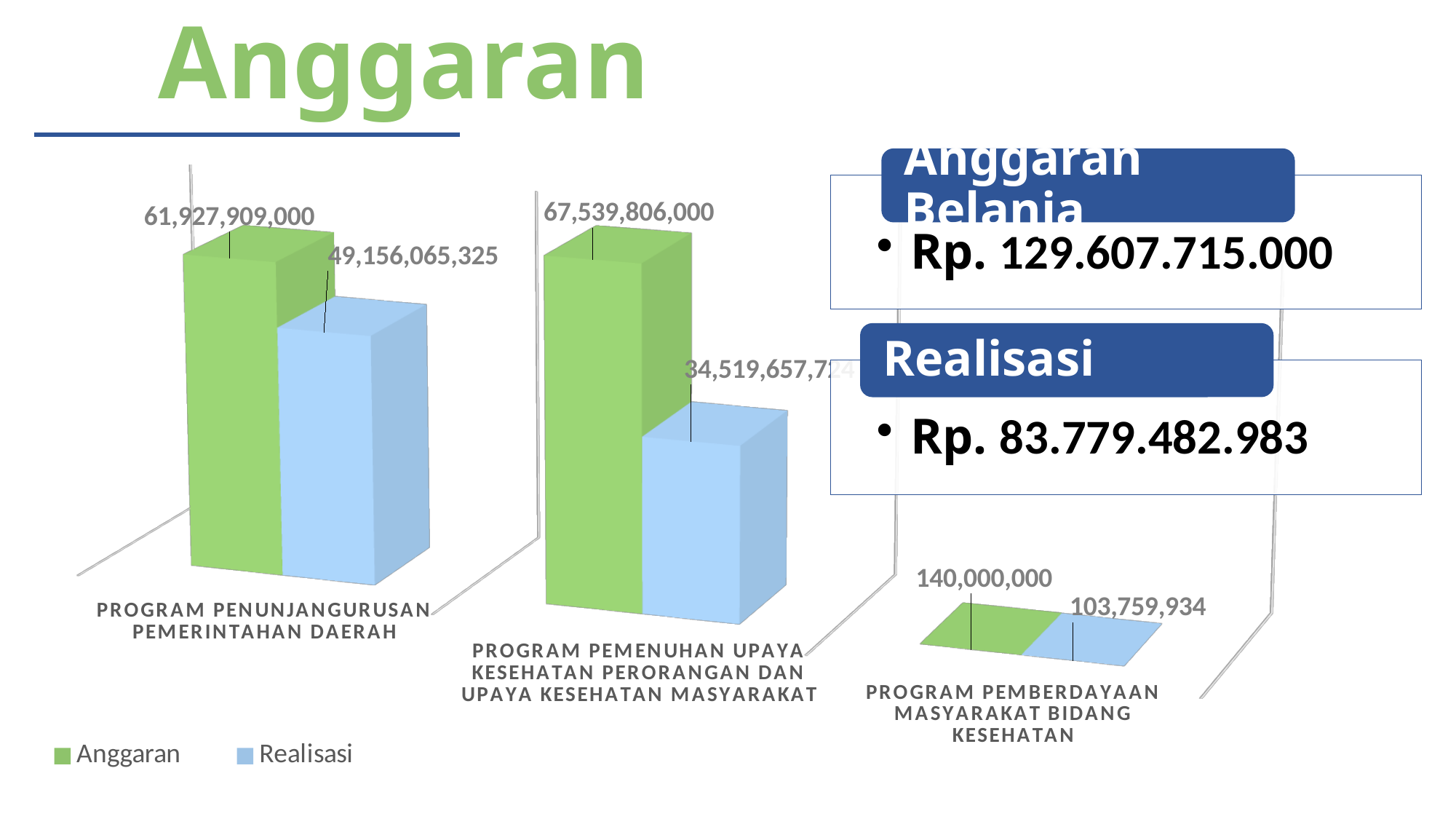
Which program has the highest Anggaran value? Program Pemenuhan Upaya Kesehatan Perorangan dan Upaya Kesehatan Masyarakat What is the Anggaran value for Program Pemenuhan Upaya Kesehatan Perorangan dan Upaya Kesehatan Masyarakat? 67,539,806,000 What is the difference between the Anggaran and Realisasi values for Program Penunjang Urusan Pemerintahan Daerah? 12,771,843,675 How many series does the legend list? 2 What is the Anggaran value for Program Penunjang Urusan Pemerintahan Daerah? 61,927,909,000 What is the Realisasi value for Program Pemberdayaan Masyarakat Bidang Kesehatan? 103,759,934 Which program has the highest Realisasi value? Program Penunjang Urusan Pemerintahan Daerah What is the Realisasi value for Program Penunjang Urusan Pemerintahan Daerah? 49,156,065,325 What is the Anggaran value for Program Pemberdayaan Masyarakat Bidang Kesehatan? 140,000,000 What is the difference between the Anggaran and Realisasi values for Program Pemberdayaan Masyarakat Bidang Kesehatan? 36,240,066 Which program has the lowest Realisasi value? Program Pemberdayaan Masyarakat Bidang Kesehatan What type of chart is shown on the slide? Bar chart